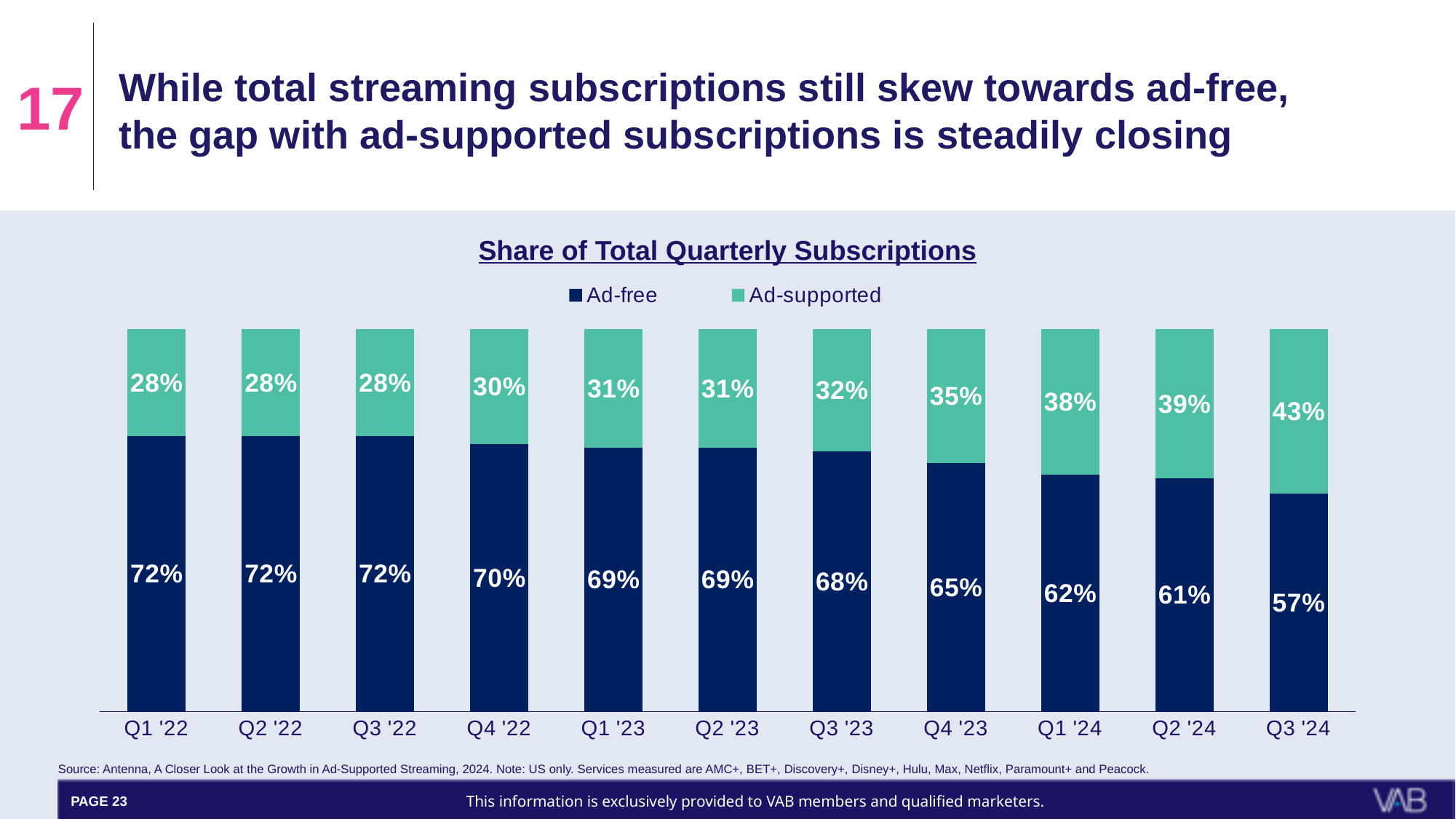
By how many percentage points did the Ad-supported share grow from Q1 '22 to Q3 '24? 15 percentage points What is the difference between the Ad-free and Ad-supported shares in Q3 '24? 14 percentage points How many quarters are shown on the x axis? 11 What is the Ad-free share of total quarterly subscriptions in Q1 '22? 72% What is the Ad-free share in Q4 '23? 65% What is the Ad-supported share of total quarterly subscriptions in Q3 '24? 43% In which quarter is the Ad-supported share highest? Q3 '24 What kind of chart is shown on the slide? Stacked bar chart In which quarter is the Ad-free share lowest? Q3 '24 Which is larger in Q2 '24, the Ad-free share or the Ad-supported share? Ad-free How many series does the legend list? 2 What is the Ad-supported share in Q1 '24? 38%